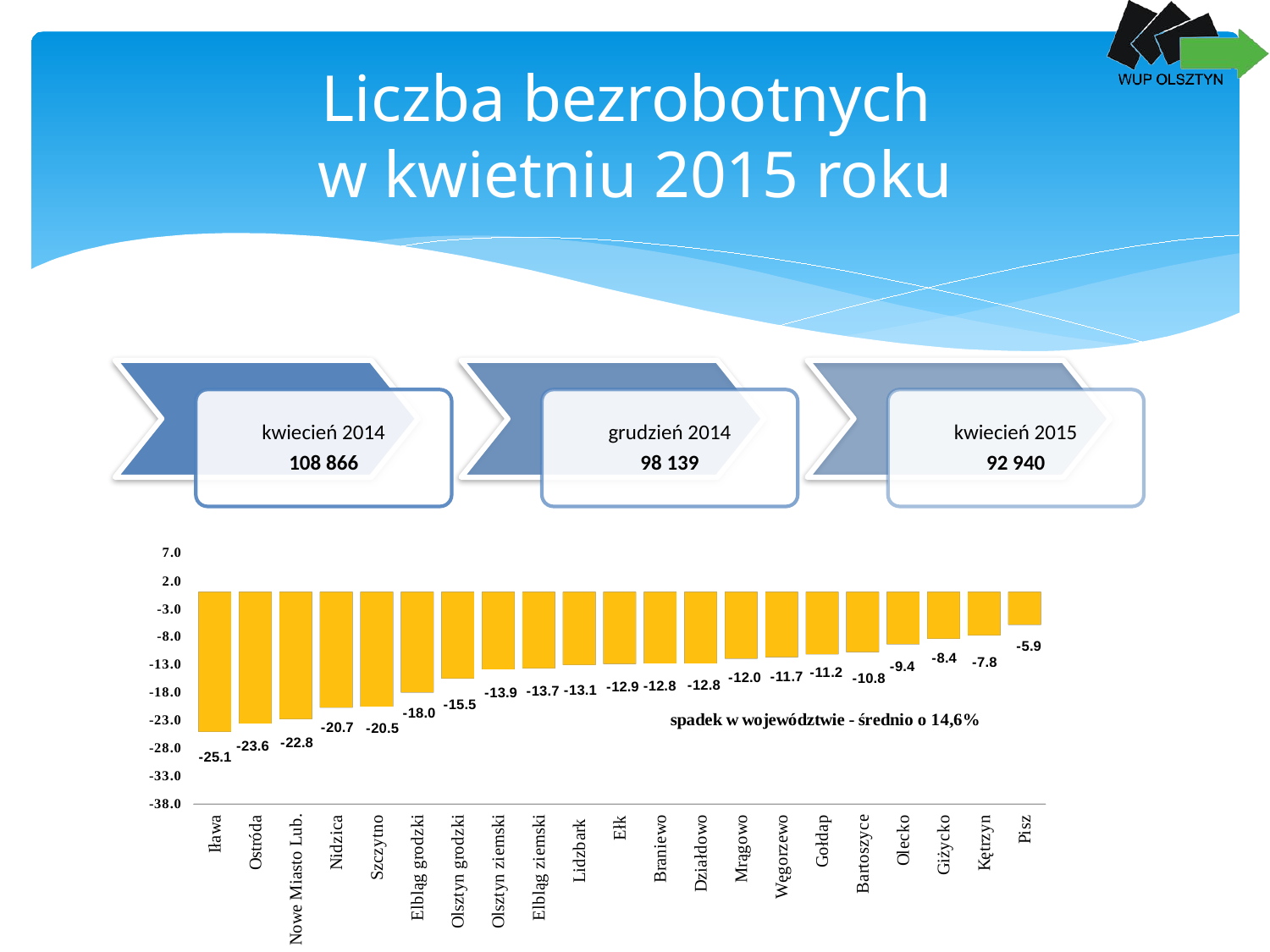
Which has a larger (less negative) value, Ostróda or Nidzica? Nidzica What is the difference between the values for Iława and Pisz? 19.2 What value is shown for Bartoszyce in the bar chart? -10.8 What value is shown for Iława in the bar chart? -25.1 What kind of chart is shown at the bottom of the slide? bar chart What value is shown for Olsztyn grodzki in the bar chart? -15.5 Do the values rise or fall moving from left to right along the x axis? rise What average decline for the voivodeship is stated in the annotation on the chart? 14,6% What value is shown for Pisz in the bar chart? -5.9 How many categories (powiats) are shown in the bar chart? 21 Which category has the highest (least negative) value in the bar chart? Pisz Which category has the lowest (most negative) value in the bar chart? Iława